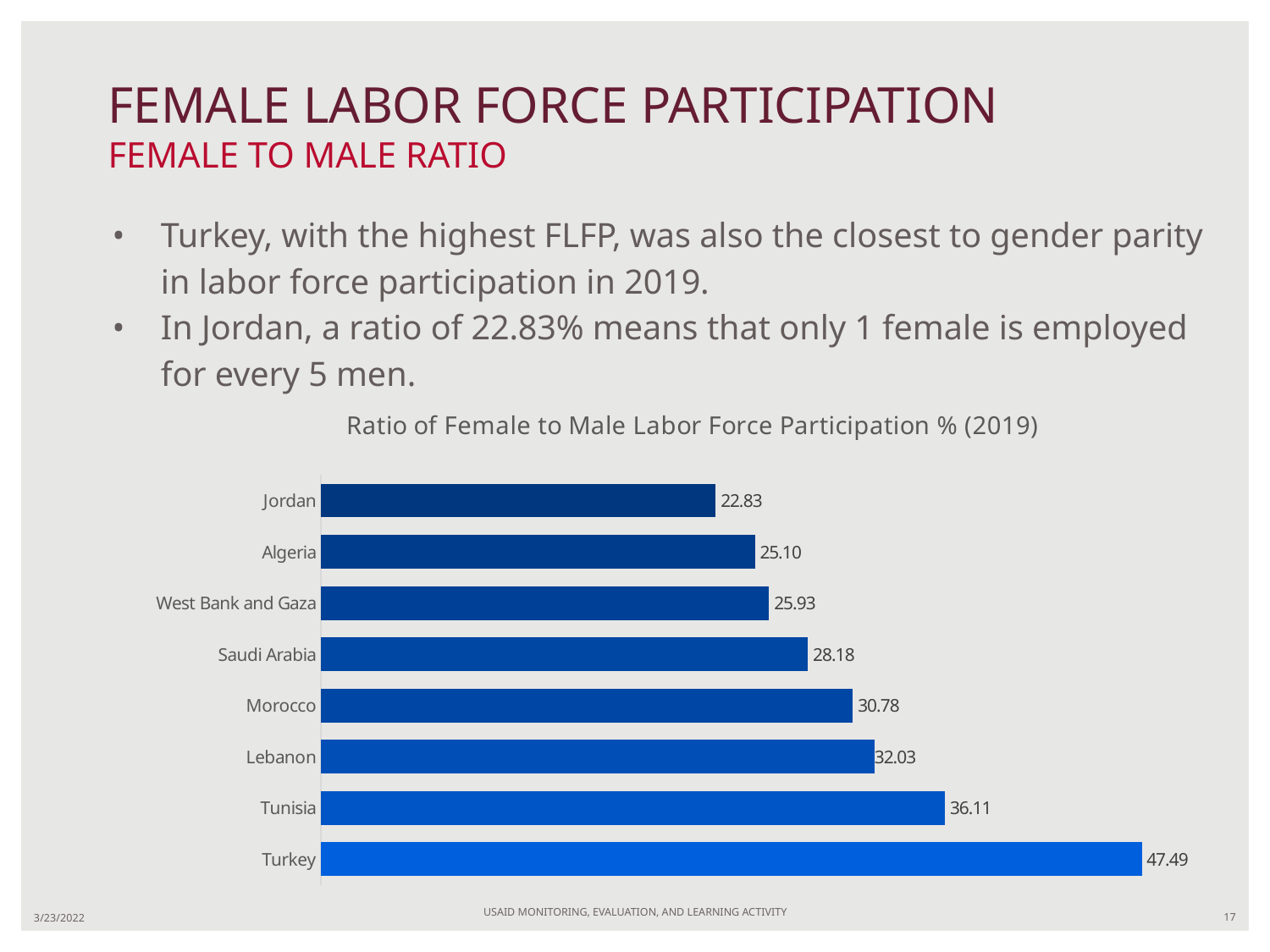
What is the value for Saudi Arabia in the chart? 28.18 What is the title of the chart? Ratio of Female to Male Labor Force Participation % (2019) How many countries are shown in the chart? 8 Which country has the lowest ratio of female to male labor force participation? Jordan Which has a higher value, Algeria or West Bank and Gaza? West Bank and Gaza What is the value for Jordan in the chart? 22.83 What is the value for Morocco in the chart? 30.78 What is the difference between the values for Lebanon and Morocco? 1.25 What is the value for Tunisia in the chart? 36.11 What kind of chart is shown on the slide? Bar chart Which country has the highest ratio of female to male labor force participation? Turkey What is the difference between the values for Turkey and Jordan? 24.66